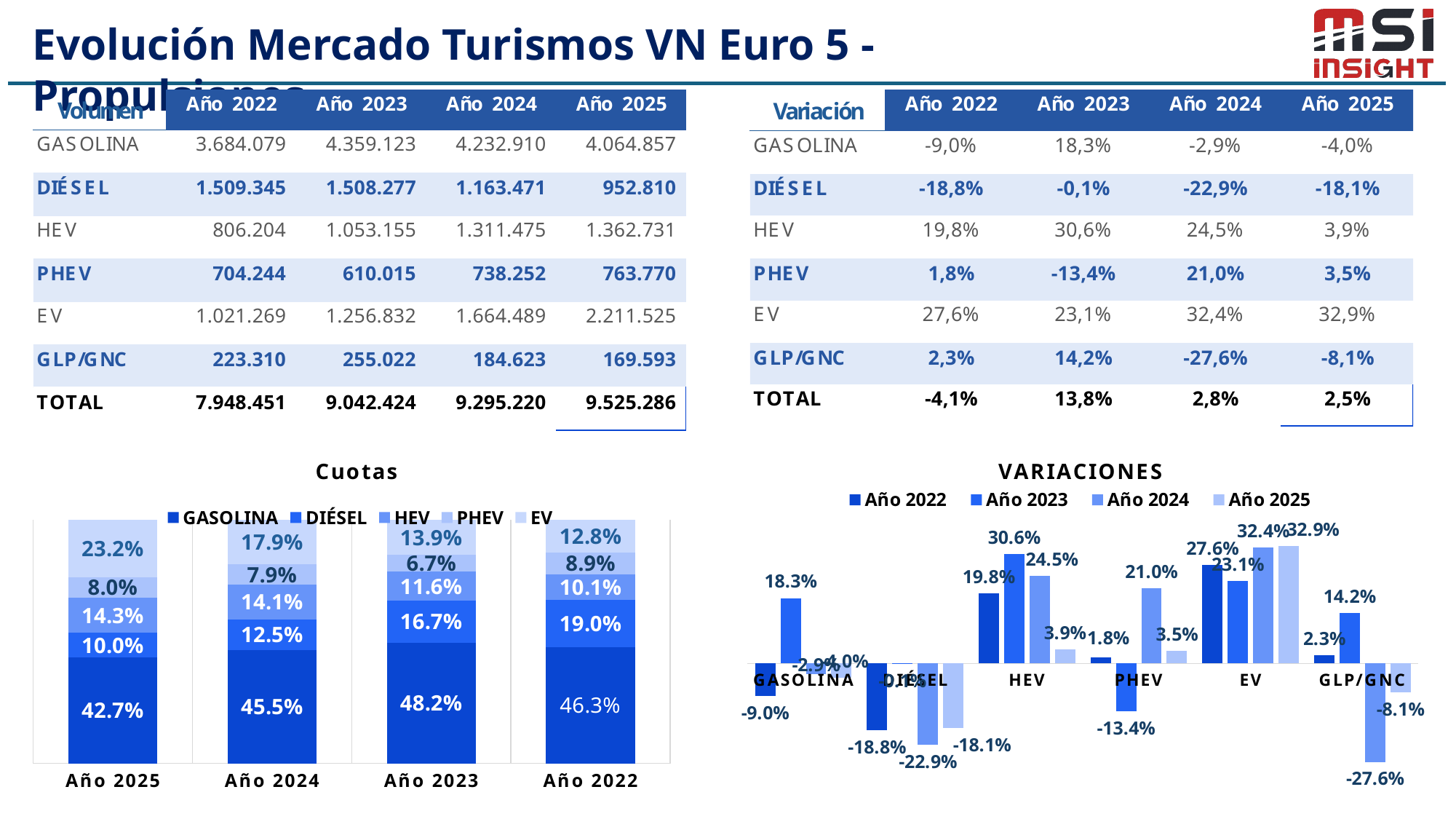
In the Cuotas chart, which year has the highest EV share? Año 2025 In the Cuotas chart, how many series does the legend list? 5 In the VARIACIONES chart, how many categories are shown on the x axis? 6 In the Cuotas chart, what is the GASOLINA share for Año 2025? 42.7% In the Cuotas chart, what is the difference between the GASOLINA share in Año 2023 and in Año 2025? 5.5% In the VARIACIONES chart, which category has the lowest value in Año 2024? GLP/GNC In the Cuotas chart, what kind of chart is it? Stacked bar chart In the VARIACIONES chart, what is the value for GLP/GNC in Año 2024? -27.6% In the VARIACIONES chart, which is larger: the EV value for Año 2022 or the EV value for Año 2023? Año 2022 In the Cuotas chart, what is the DIÉSEL share for Año 2023? 16.7% In the VARIACIONES chart, what is the value for HEV in Año 2023? 30.6% In the Cuotas chart, what is the EV share for Año 2022? 12.8%